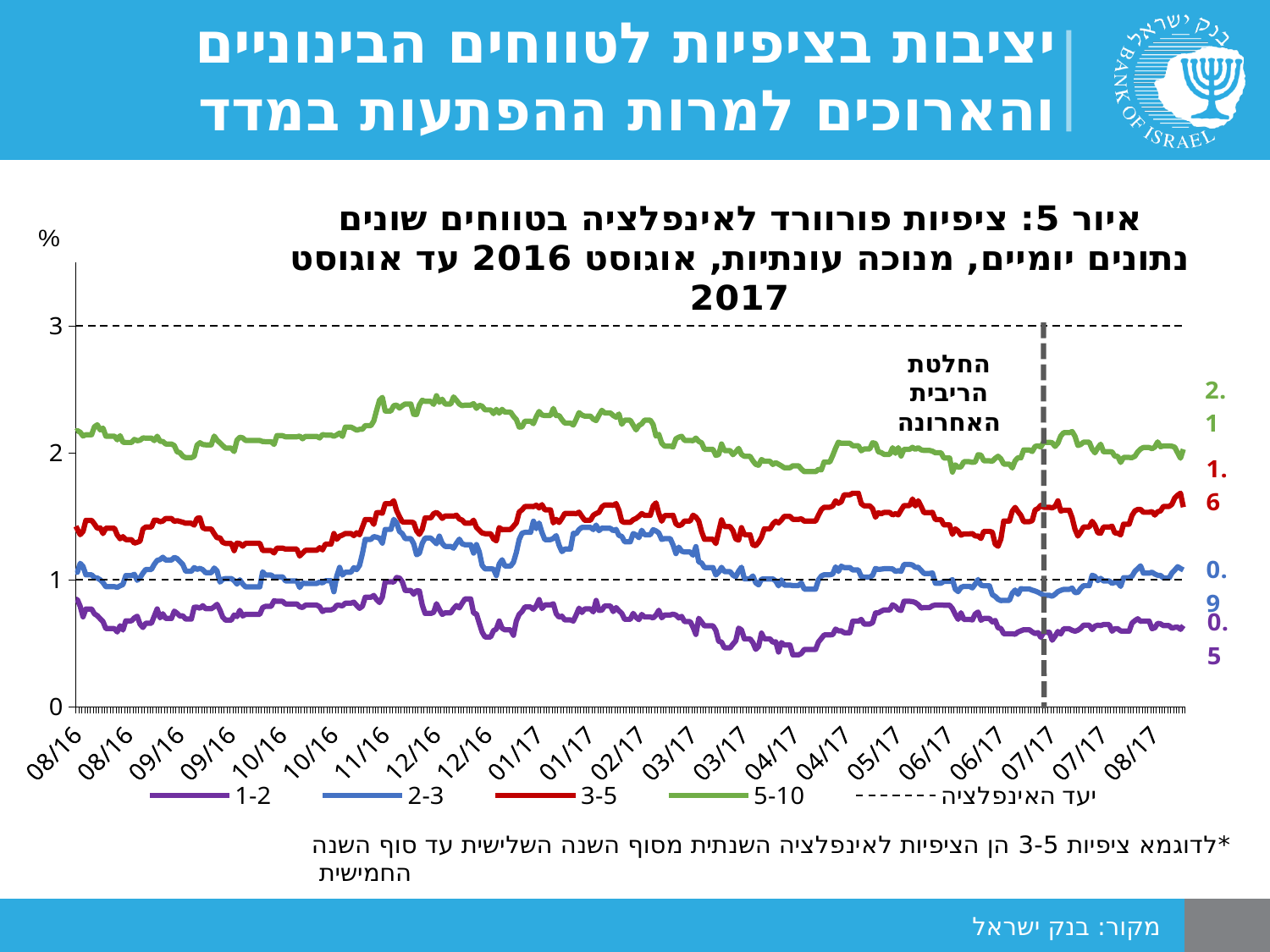
What value is labelled at the right end of the 1-2 series? 0.5 What is the difference between the end values of the 5-10 series and the 1-2 series? 1.6 What value is labelled at the right end of the 2-3 series? 0.9 How many entries does the legend list? 5 Is the value of the 5-10 series in 11/16 greater or less than 2? greater What value is labelled at the right end of the 5-10 series? 2.1 Which series has the lowest value at the right end of the chart? 1-2 What kind of chart is shown on the slide? line chart Is the value of the 1-2 series in 04/17 greater or less than 1? less What value is labelled at the right end of the 3-5 series? 1.6 What does the vertical dashed line near 07/17 mark, according to its label? החלטת הריבית האחרונה Which series has the highest value at the right end of the chart? 5-10